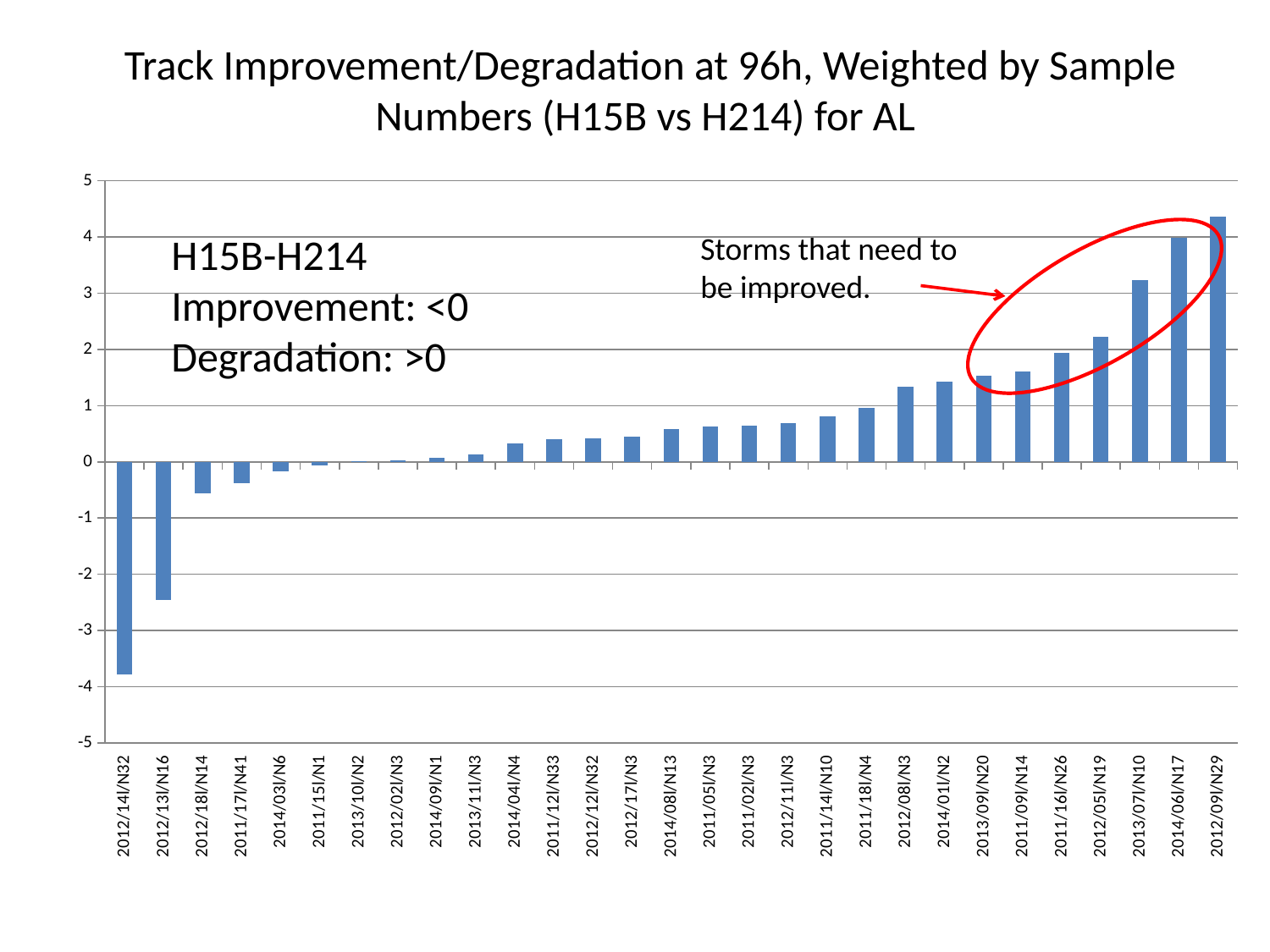
Is the value for 2012/13l/N16 greater or less than -2? less Do the bar values rise or fall moving from left to right along the x axis? rise Is the value for 2013/07l/N10 greater or less than 3? greater What kind of chart is shown on the slide? bar chart Which storm has the highest value? 2012/09l/N29 Is the value for 2012/09l/N29 greater or less than 4? greater What is the title of the chart? Track Improvement/Degradation at 96h, Weighted by Sample Numbers (H15B vs H214) for AL How many storm categories are plotted along the x axis? 29 Which has the larger value, 2012/14l/N32 or 2012/13l/N16? 2012/13l/N16 Which storm has the lowest value? 2012/14l/N32